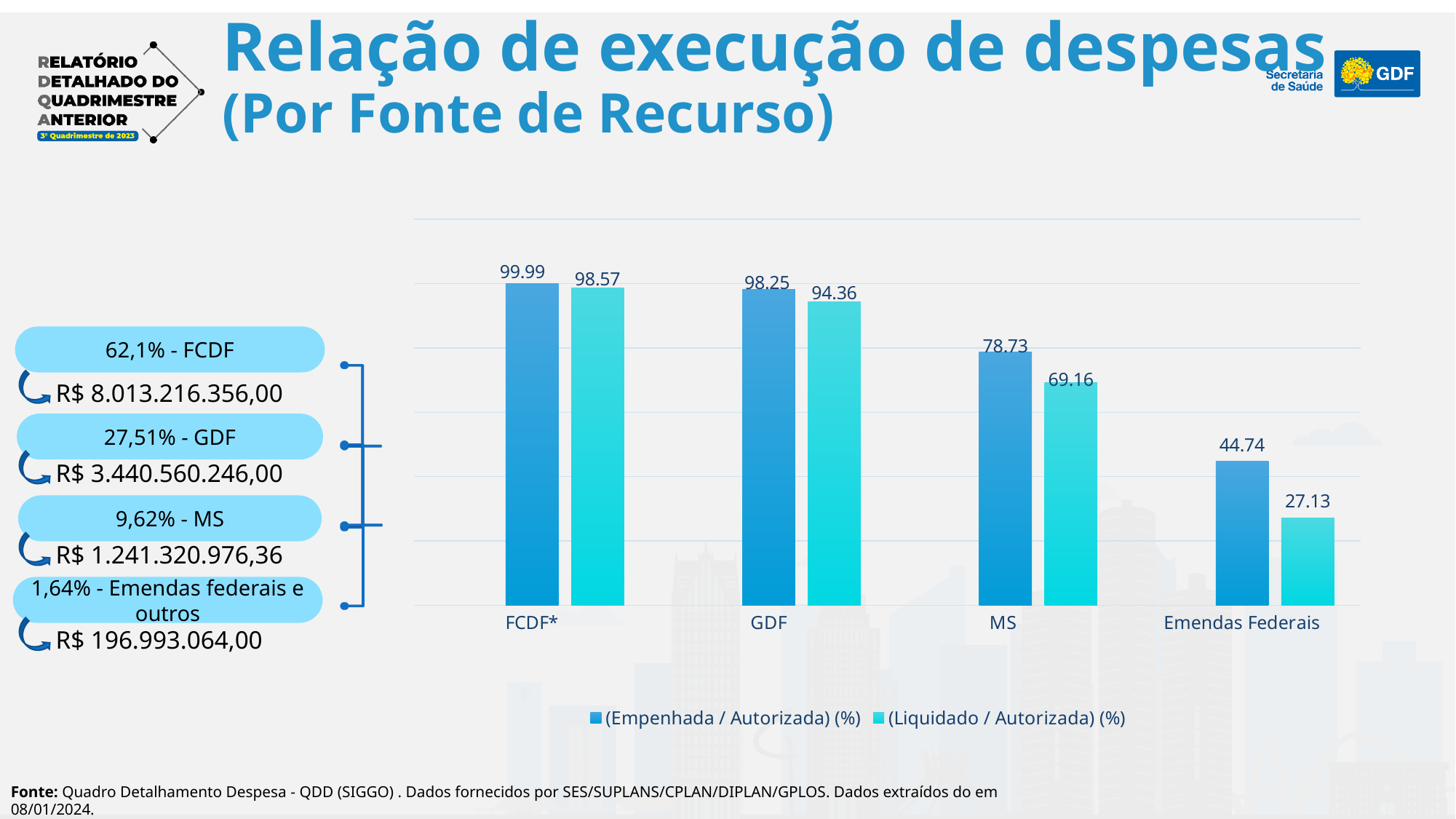
What is the (Empenhada / Autorizada) (%) value for FCDF*? 99.99 Which category has the lowest (Liquidado / Autorizada) (%) value? Emendas Federais What is the (Liquidado / Autorizada) (%) value for GDF? 94.36 What is the difference between the (Empenhada / Autorizada) (%) and (Liquidado / Autorizada) (%) values for Emendas Federais? 17.61 Which is larger: the (Liquidado / Autorizada) (%) value for GDF or for MS? GDF How many categories are shown on the x axis of the chart? 4 What is the difference between the (Empenhada / Autorizada) (%) and (Liquidado / Autorizada) (%) values for MS? 9.57 What kind of chart is shown on the slide? Bar chart How many series does the chart legend list? 2 What is the (Empenhada / Autorizada) (%) value for Emendas Federais? 44.74 What is the (Liquidado / Autorizada) (%) value for MS? 69.16 Which category has the highest (Empenhada / Autorizada) (%) value? FCDF*